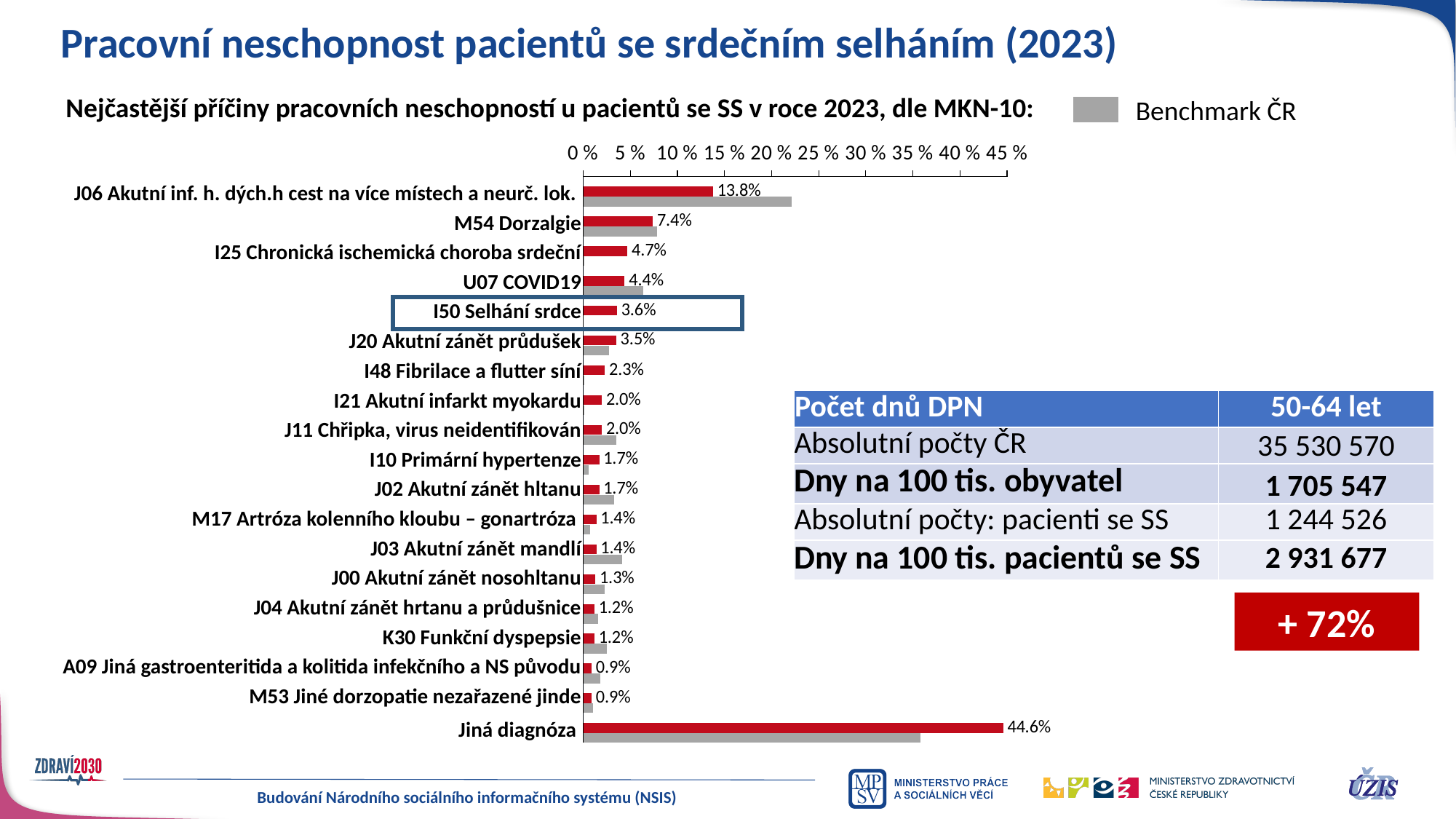
Which category has the highest labelled value? Jiná diagnóza What is the value for J06 Akutní inf. h. dých.h cest na více místech a neurč. lok.? 13.8% Which series does the grey colour in the legend represent? Benchmark ČR Is the Benchmark ČR value for J06 Akutní inf. h. dých.h cest na více místech a neurč. lok. greater or less than 15 %? greater What is the value for I50 Selhání srdce? 3.6% What is the difference between the values for J06 Akutní inf. h. dých.h cest na více místech a neurč. lok. and M54 Dorzalgie? 6.4 percentage points How many categories are shown on the chart? 19 What is the value for U07 COVID19? 4.4% What is the value for Jiná diagnóza? 44.6% Which is larger, the value for I25 Chronická ischemická choroba srdeční or the value for U07 COVID19? I25 Chronická ischemická choroba srdeční What type of chart is shown on the slide? bar chart